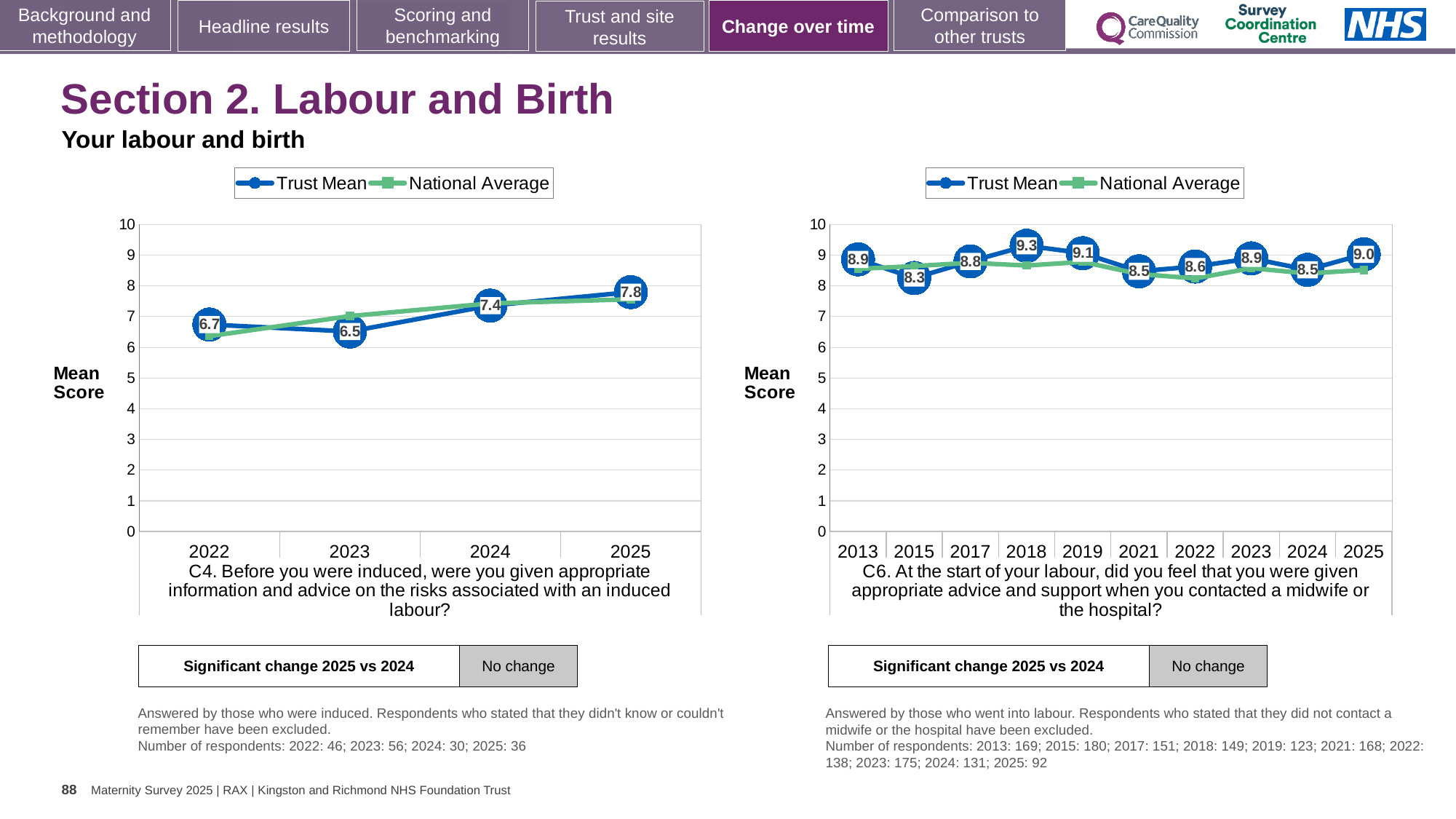
In the C4 chart on the left, how many years are shown on the x axis? 4 In the C4 chart on the left, what is the Trust Mean for 2023? 6.5 In the C6 chart on the right, which year has the lowest Trust Mean? 2015 In the C6 chart on the right, what is the Trust Mean for 2018? 9.3 In the C4 chart on the left, what is the difference between the Trust Mean for 2025 and 2022? 1.1 In the C6 chart on the right, which year has the highest Trust Mean? 2018 In the C4 chart on the left, which year has the lowest Trust Mean? 2023 In the C6 chart on the right, how many years are shown on the x axis? 10 In the C6 chart on the right, is the Trust Mean for 2019 or 2021 larger? 2019 In the C4 chart on the left, what is the Trust Mean for 2025? 7.8 How many series does the legend of the C4 chart on the left list? 2 What kind of chart is the C6 chart on the right? Line chart